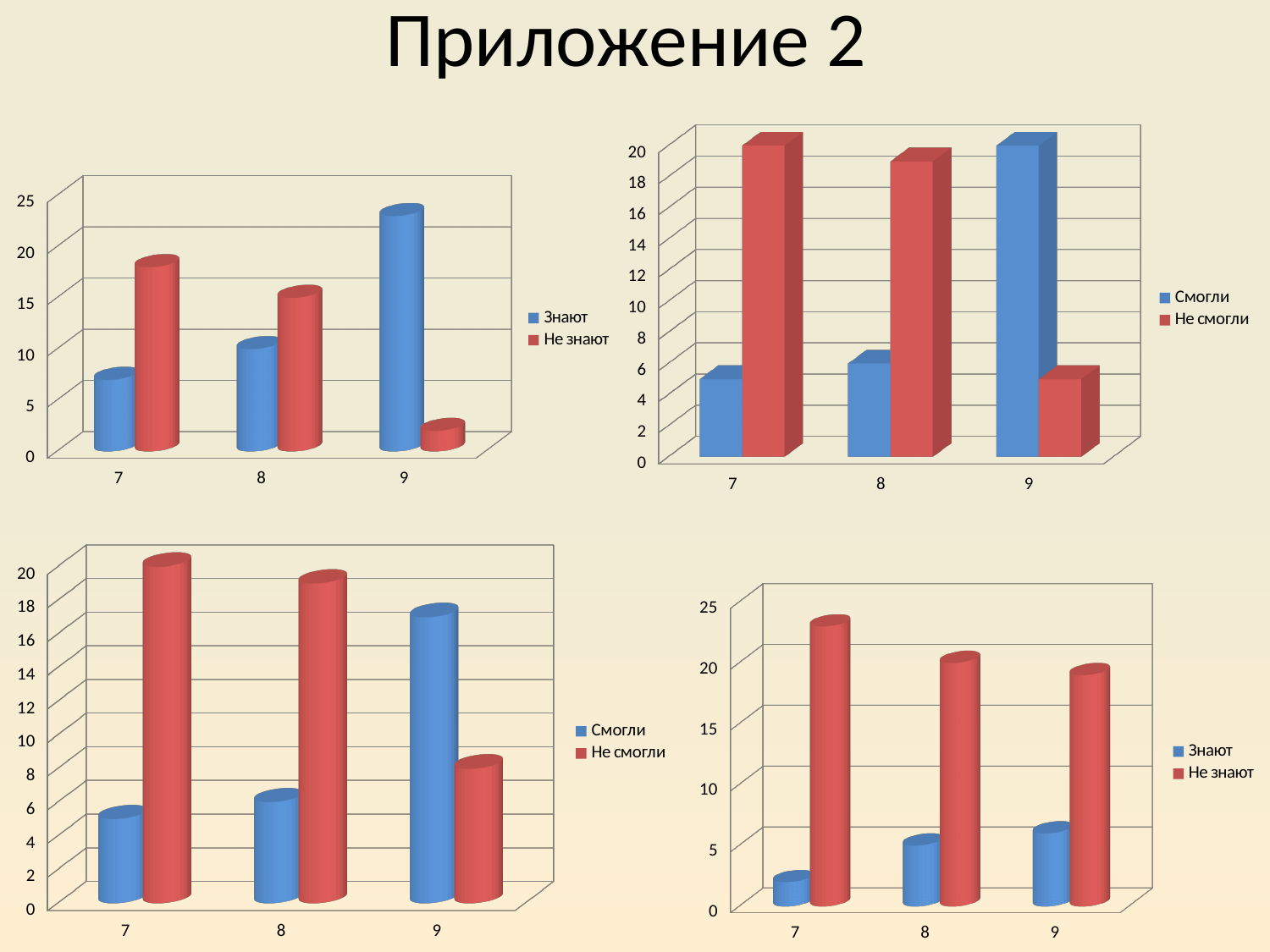
In the top-right chart, at category 7, which series has the larger value, Смогли or Не смогли? Не смогли In the bottom-right chart, how many categories are shown on the x axis? 3 In the top-right chart, how many series does the legend list? 2 In the top-left chart, do the values for Знают rise or fall from category 7 to category 9? rise What kind of chart is the bottom-right chart? bar chart In the bottom-right chart, for which category is the value of Не знают highest? 7 In the bottom-left chart, is the value for Смогли at category 9 greater or less than 10? greater In the bottom-left chart, for which category is the value of Не смогли lowest? 9 In the top-left chart, at category 9, which series has the larger value, Знают or Не знают? Знают In the bottom-right chart, is the value for Знают at category 7 greater or less than 5? less In the top-left chart, is the value for Не знают at category 9 greater or less than 5? less